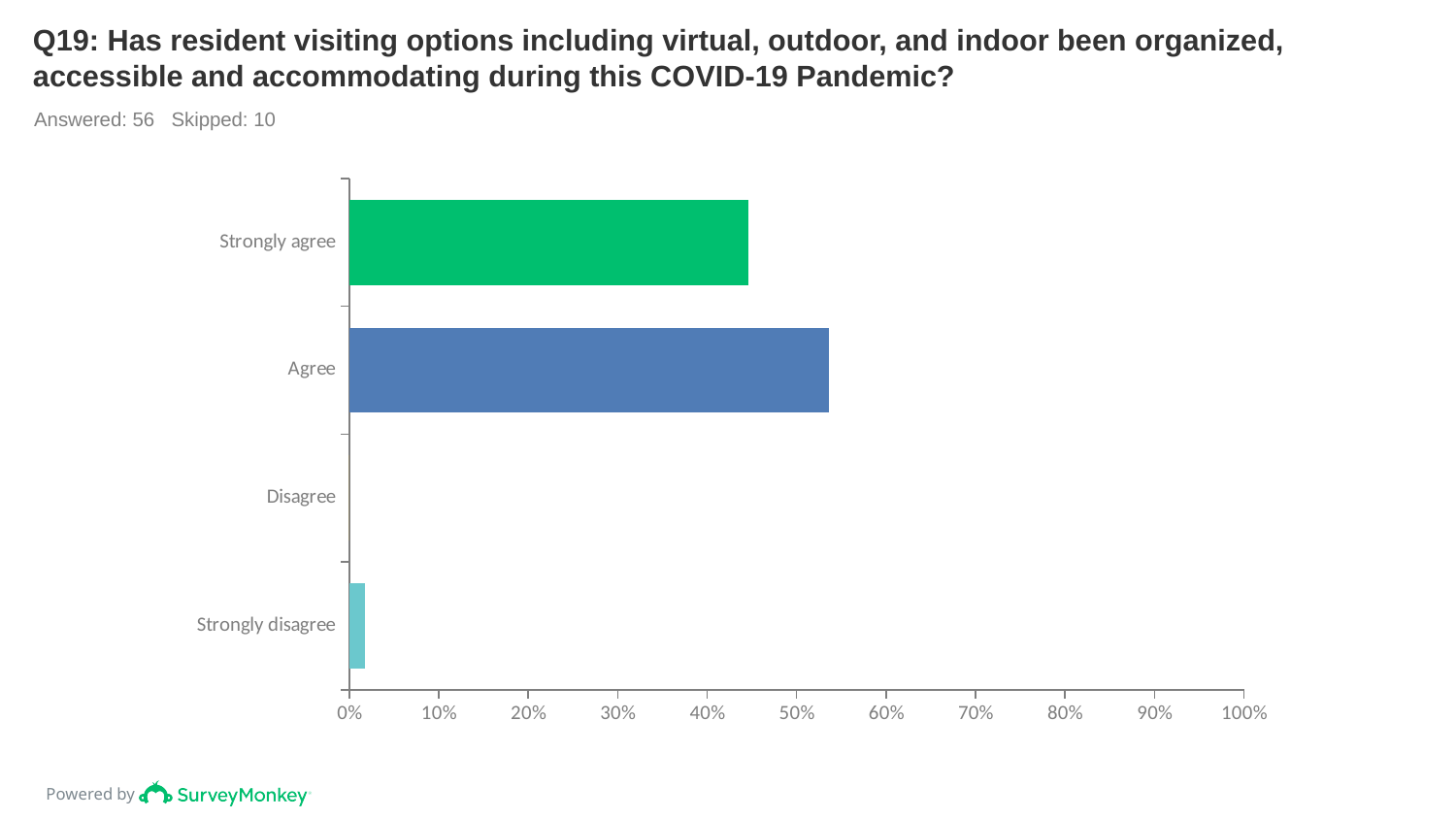
What kind of chart is shown on the slide? bar chart Which is larger, the value for Strongly agree or the value for Agree? Agree What is the maximum value shown on the horizontal axis? 100% Is the value for Strongly disagree greater or less than 10%? less Which is larger, the value for Strongly disagree or the value for Disagree? Strongly disagree Which category has the lowest value? Disagree Is the value for Strongly agree greater or less than 50%? less Is the value for Agree greater or less than 50%? greater How many respondents answered this question according to the slide? 56 How many categories are shown on the chart? 4 Which category has the highest value? Agree